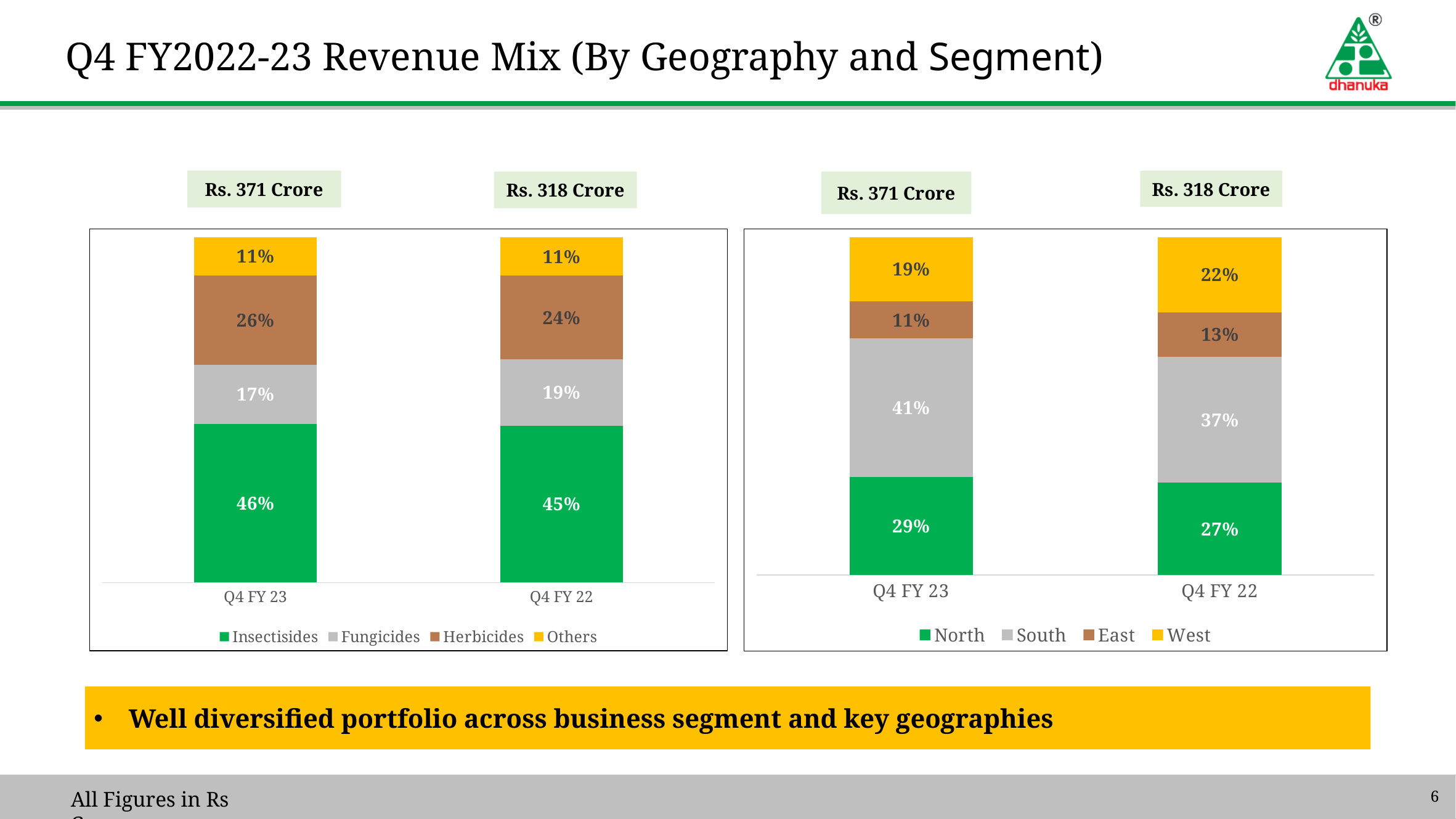
How many bars are plotted in the left chart (segment mix)? 2 In the right chart (geography mix), which region has the smallest share in Q4 FY 23? East How many series does the legend of the right chart (geography mix) list? 4 In the right chart (geography mix), what colour represents North in the legend? Green In the left chart (segment mix), what is the Insectisides share for Q4 FY 23? 46% In the right chart (geography mix), is the South share larger in Q4 FY 23 or Q4 FY 22? Q4 FY 23 In the left chart (segment mix), what is the Herbicides share for Q4 FY 22? 24% In the right chart (geography mix), what is the South share for Q4 FY 23? 41% In the left chart (segment mix), which segment has the largest share in Q4 FY 23? Insectisides What kind of chart is the right chart (geography mix)? Stacked bar chart In the right chart (geography mix), what is the West share for Q4 FY 22? 22% In the left chart (segment mix), what is the difference between the Herbicides share in Q4 FY 23 and Q4 FY 22? 2%